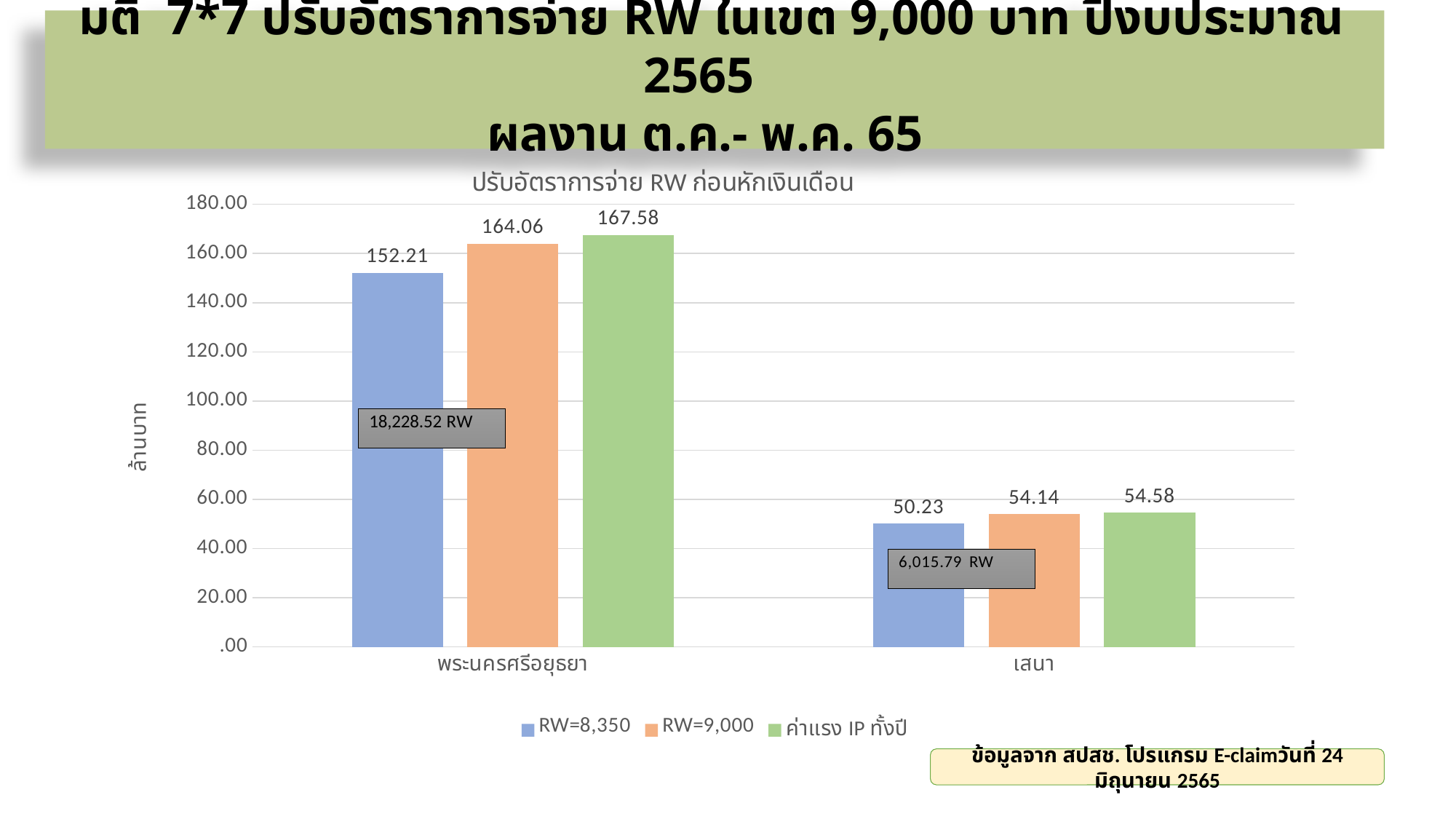
Which series has the highest value for พระนครศรีอยุธยา? ค่าแรง IP ทั้งปี Which is larger: the RW=9,000 value for เสนา or the RW=8,350 value for เสนา? RW=9,000 What is the value for RW=9,000 for เสนา? 54.14 What is the value for ค่าแรง IP ทั้งปี for พระนครศรีอยุธยา? 167.58 Which series has the lowest value for เสนา? RW=8,350 How many series does the legend list? 3 What is the value for RW=8,350 for พระนครศรีอยุธยา? 152.21 What is the value for RW=8,350 for เสนา? 50.23 How many categories are shown on the x axis? 2 What type of chart is shown on the slide? bar chart What is the title of the chart? ปรับอัตราการจ่าย RW ก่อนหักเงินเดือน What is the difference between the RW=9,000 and RW=8,350 values for พระนครศรีอยุธยา? 11.85